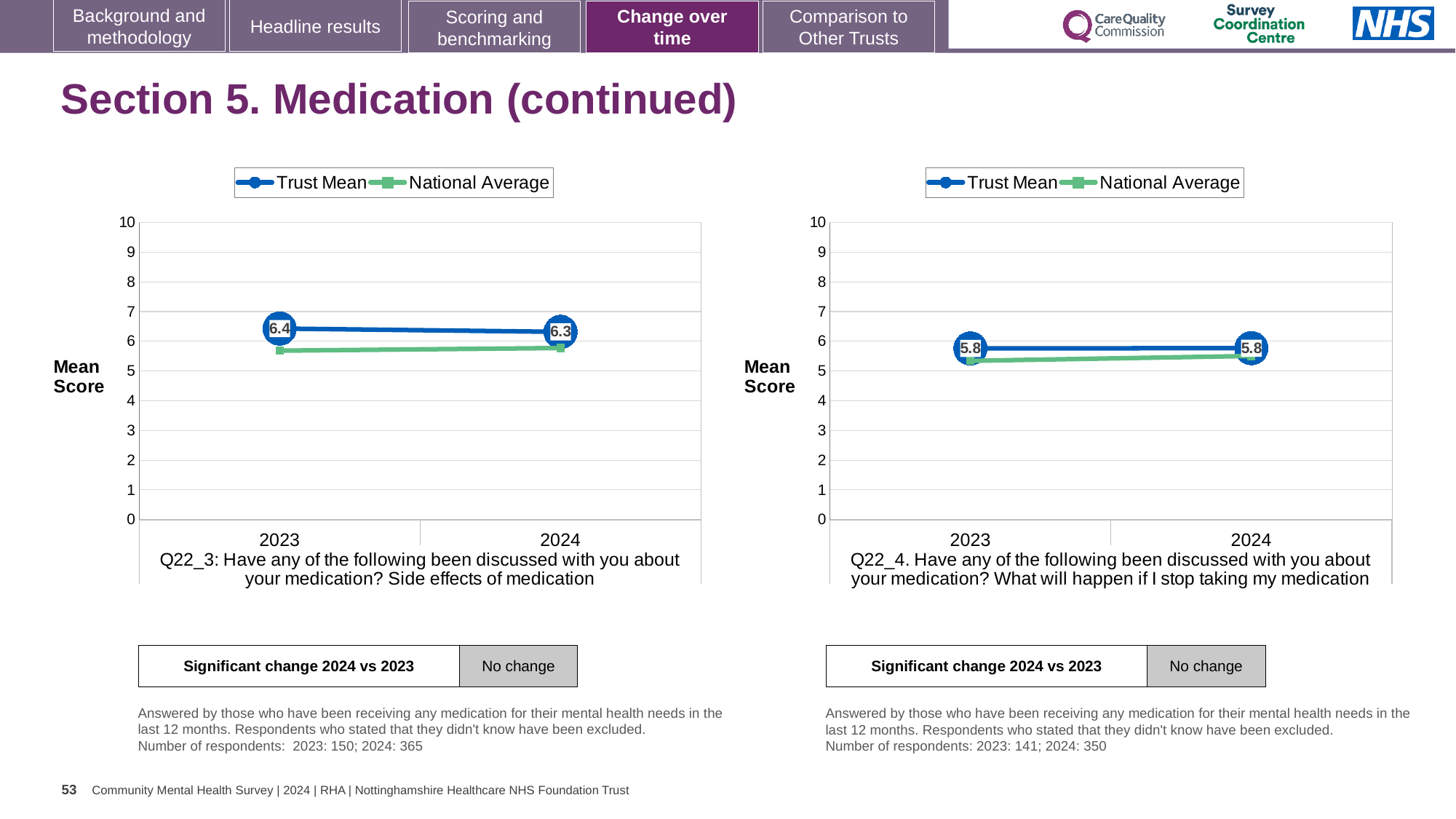
In the left chart (Q22_3), what is the Trust Mean score for 2023? 6.4 In the left chart (Q22_3), what is the Trust Mean score for 2024? 6.3 What kind of chart is the right chart (Q22_4)? line chart In the right chart (Q22_4), is the National Average value for 2024 greater or less than 6? less In the left chart (Q22_3), is the National Average value for 2023 greater or less than 6? less In the right chart (Q22_4), does the Trust Mean rise, fall or stay the same from 2023 to 2024? stays the same In the right chart (Q22_4), what is the Trust Mean score for 2024? 5.8 In the left chart (Q22_3), what is the difference between the Trust Mean scores for 2023 and 2024? 0.1 How many years are plotted on the x axis of the left chart (Q22_3)? 2 How many series does the legend of the right chart (Q22_4) list? 2 In the left chart (Q22_3), does the Trust Mean rise or fall from 2023 to 2024? fall In the left chart (Q22_3), which series has the higher value in 2023, Trust Mean or National Average? Trust Mean